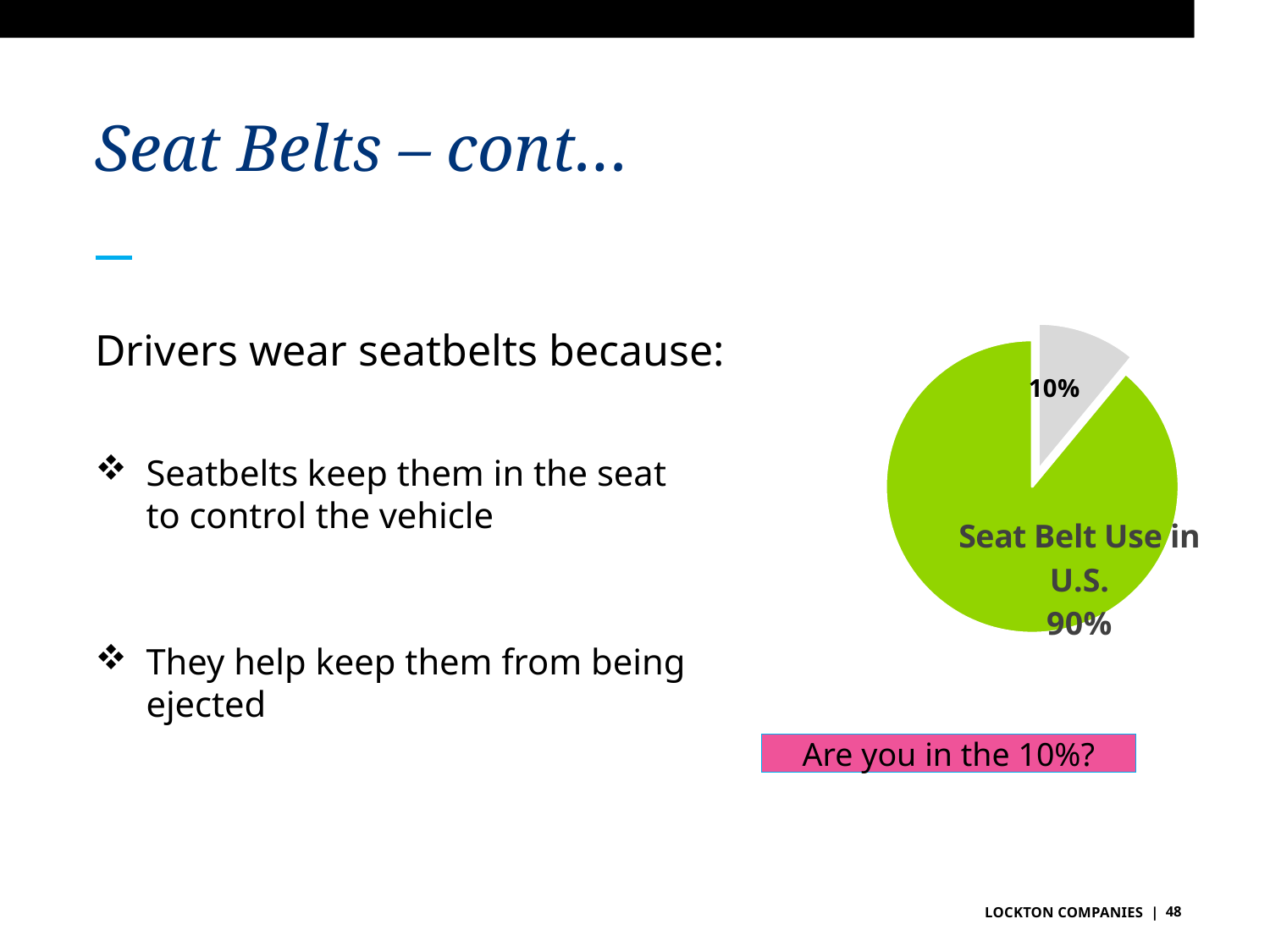
Which is larger in the pie chart, the green slice or the grey slice? the green slice What percentage is shown on the grey slice of the pie chart? 10% What share of the pie does the "Seat Belt Use in U.S." slice represent? 90% Which slice of the pie chart is the smallest? the grey 10% slice What kind of chart is shown on the slide? pie chart What colour is the slice labelled "Seat Belt Use in U.S." in the pie chart? green What percentage is shown for the "Seat Belt Use in U.S." slice of the pie chart? 90% What is the difference in percentage points between the 90% slice and the 10% slice? 80 How many slices does the pie chart have? 2 Which slice of the pie chart is the largest? Seat Belt Use in U.S. (90%) What colour is the 10% slice of the pie chart? grey